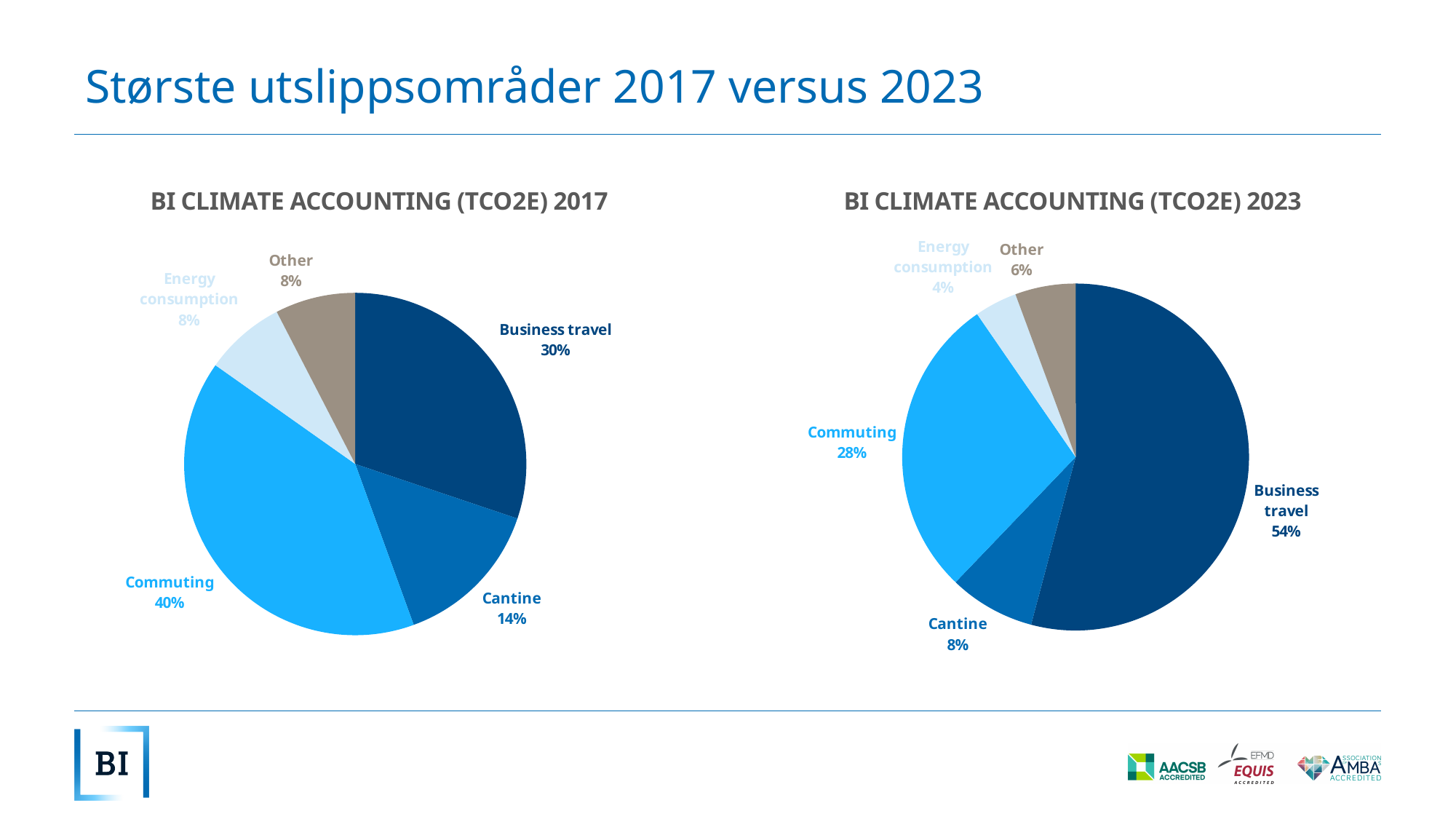
In the 'BI CLIMATE ACCOUNTING (TCO2E) 2023' chart, what share does Energy consumption have? 4% In the 'BI CLIMATE ACCOUNTING (TCO2E) 2017' chart, what share does Commuting have? 40% In the 'BI CLIMATE ACCOUNTING (TCO2E) 2017' chart, which is larger, Cantine or Other? Cantine In the 'BI CLIMATE ACCOUNTING (TCO2E) 2017' chart, which category has the largest share? Commuting What type of chart is the 'BI CLIMATE ACCOUNTING (TCO2E) 2017' chart? Pie chart In the 'BI CLIMATE ACCOUNTING (TCO2E) 2023' chart, what share does Business travel have? 54% What is the title of the chart on the right side of the slide? BI CLIMATE ACCOUNTING (TCO2E) 2023 What is the difference in percentage points between Business travel in the 2023 chart and Business travel in the 2017 chart? 24 percentage points How many categories are shown in the 'BI CLIMATE ACCOUNTING (TCO2E) 2023' chart? 5 In the 'BI CLIMATE ACCOUNTING (TCO2E) 2023' chart, which category has the smallest share? Energy consumption In the 'BI CLIMATE ACCOUNTING (TCO2E) 2017' chart, what is the difference in percentage points between Commuting and Business travel? 10 percentage points In the 'BI CLIMATE ACCOUNTING (TCO2E) 2023' chart, which category has the largest share? Business travel